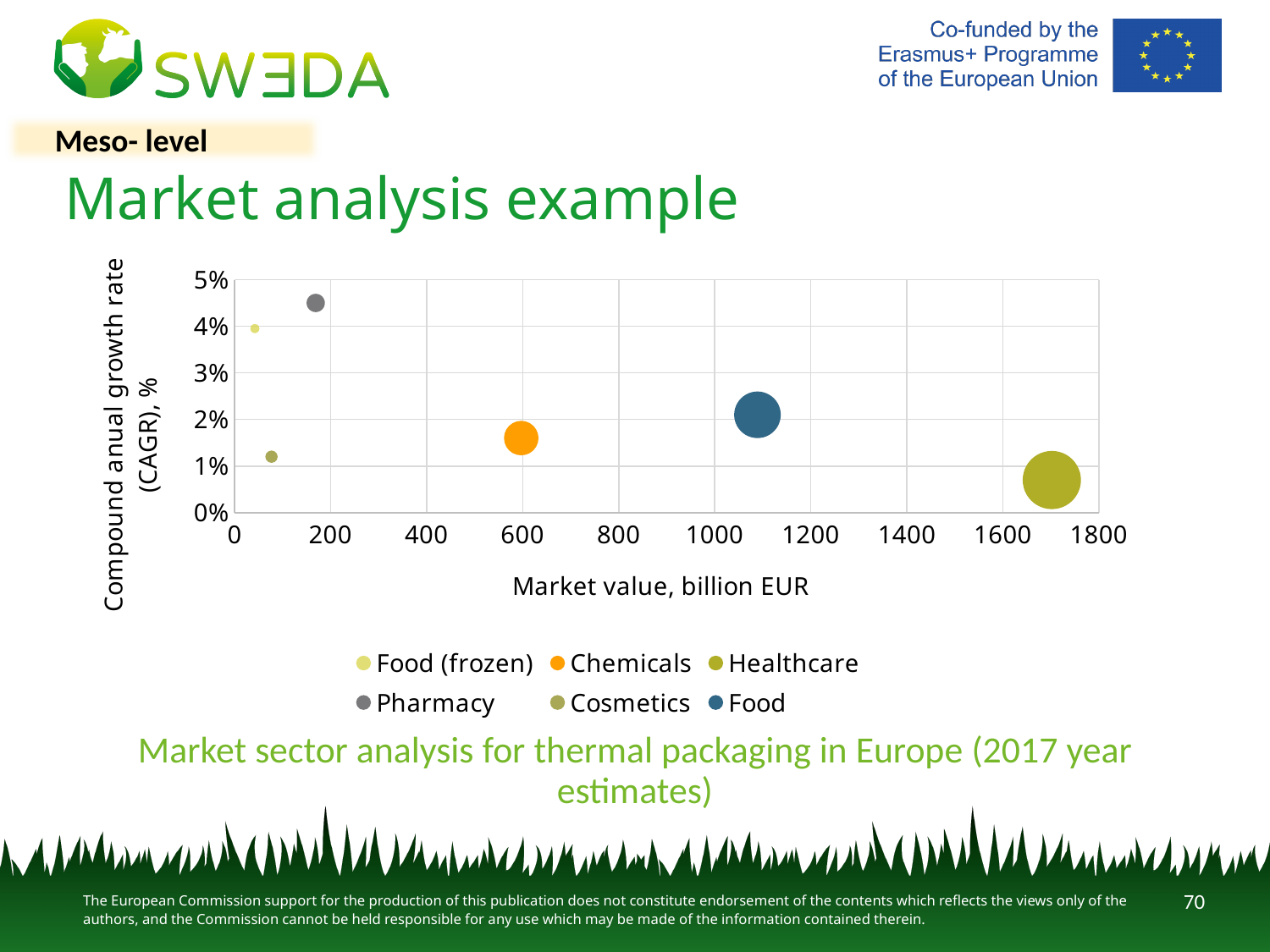
What kind of chart is shown on the slide? bubble chart Which has the higher compound annual growth rate, Food (frozen) or Cosmetics? Food (frozen) How many series does the chart legend list? 6 Which has the larger market value, Food or Chemicals? Food How many bubbles are plotted on the chart? 6 Is the market value for Healthcare greater or less than 1600 billion EUR? greater Is the market value for Food greater or less than 1000 billion EUR? greater What is the label of the horizontal axis of the chart? Market value, billion EUR Which sector has the highest market value on the chart? Healthcare Which sector has the highest compound annual growth rate on the chart? Pharmacy Is the compound annual growth rate for Chemicals greater or less than 2%? less Which sector has the lowest compound annual growth rate on the chart? Healthcare